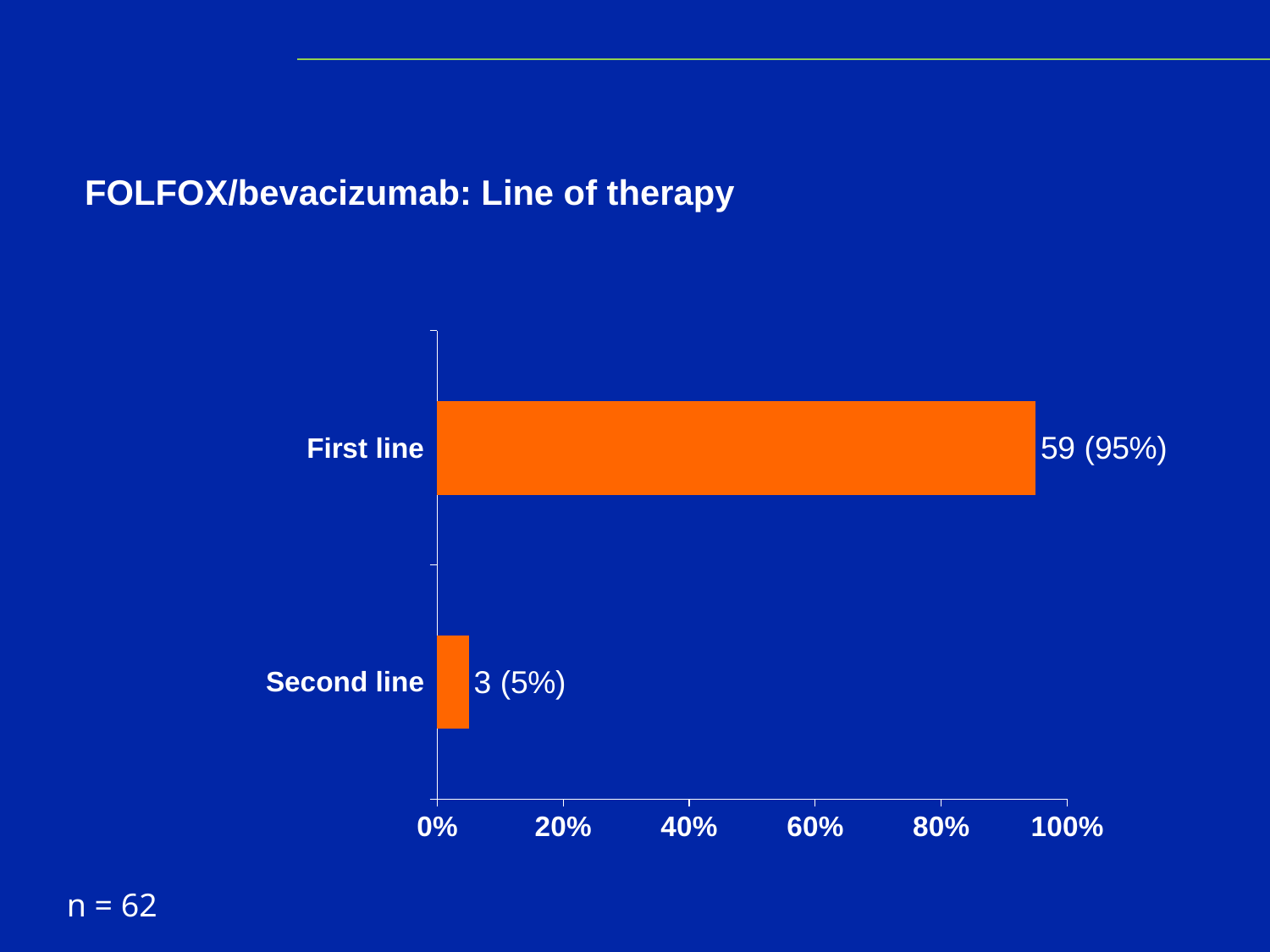
Is the value for Second line greater or less than 20%? less Which line of therapy has the highest value? First line What is the title of the chart? FOLFOX/bevacizumab: Line of therapy How many more patients received First line than Second line? 56 Which is larger, the value for First line or Second line? First line Is the value for First line greater or less than 80%? greater How many categories are shown in the chart? 2 Which line of therapy has the lowest value? Second line What kind of chart is shown on the slide? Bar chart What is the data label shown for Second line? 3 (5%) What is the difference in percentage points between First line and Second line? 90 percentage points What is the data label shown for First line? 59 (95%)